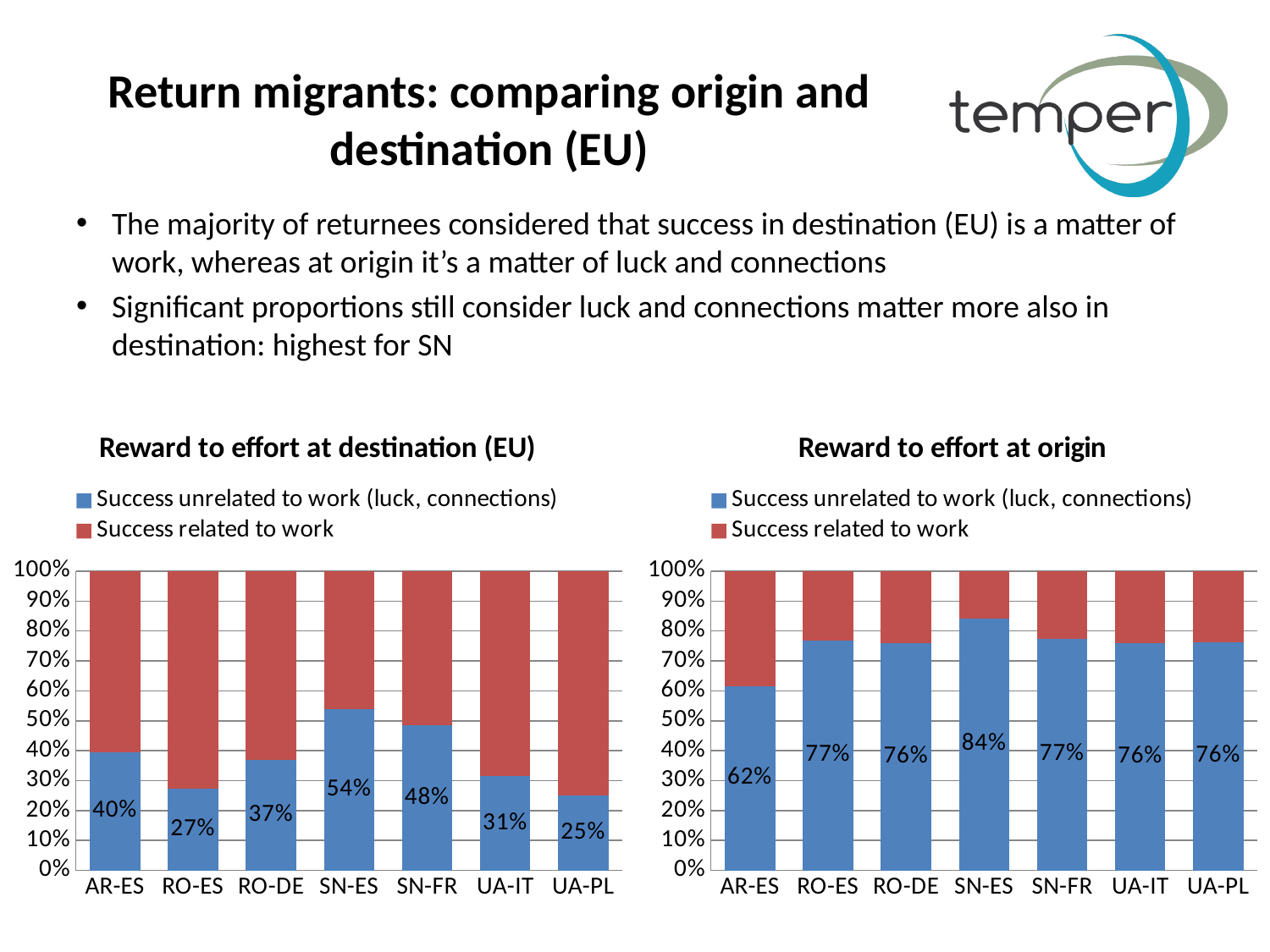
In the 'Reward to effort at origin' chart, what is the value for 'Success unrelated to work (luck, connections)' for AR-ES? 62% In the 'Reward to effort at destination (EU)' chart, what is the difference between the 'Success unrelated to work (luck, connections)' values for SN-ES and RO-ES? 27% In the 'Reward to effort at destination (EU)' chart, which category has the highest value for 'Success unrelated to work (luck, connections)'? SN-ES In the 'Reward to effort at destination (EU)' chart, which category has the lowest value for 'Success unrelated to work (luck, connections)'? UA-PL In the 'Reward to effort at origin' chart, which category has the highest value for 'Success unrelated to work (luck, connections)'? SN-ES In the 'Reward to effort at destination (EU)' chart, what is the value for 'Success unrelated to work (luck, connections)' for SN-ES? 54% In the 'Reward to effort at destination (EU)' chart, which has a larger 'Success unrelated to work (luck, connections)' value, AR-ES or UA-IT? AR-ES In the 'Reward to effort at origin' chart, which category has the lowest value for 'Success unrelated to work (luck, connections)'? AR-ES In the 'Reward to effort at origin' chart, what is the difference between the 'Success unrelated to work (luck, connections)' values for SN-ES and AR-ES? 22% How many series does the legend of the 'Reward to effort at destination (EU)' chart list? 2 How many categories are shown on the x axis of the 'Reward to effort at origin' chart? 7 What kind of chart is 'Reward to effort at origin'? Stacked bar chart